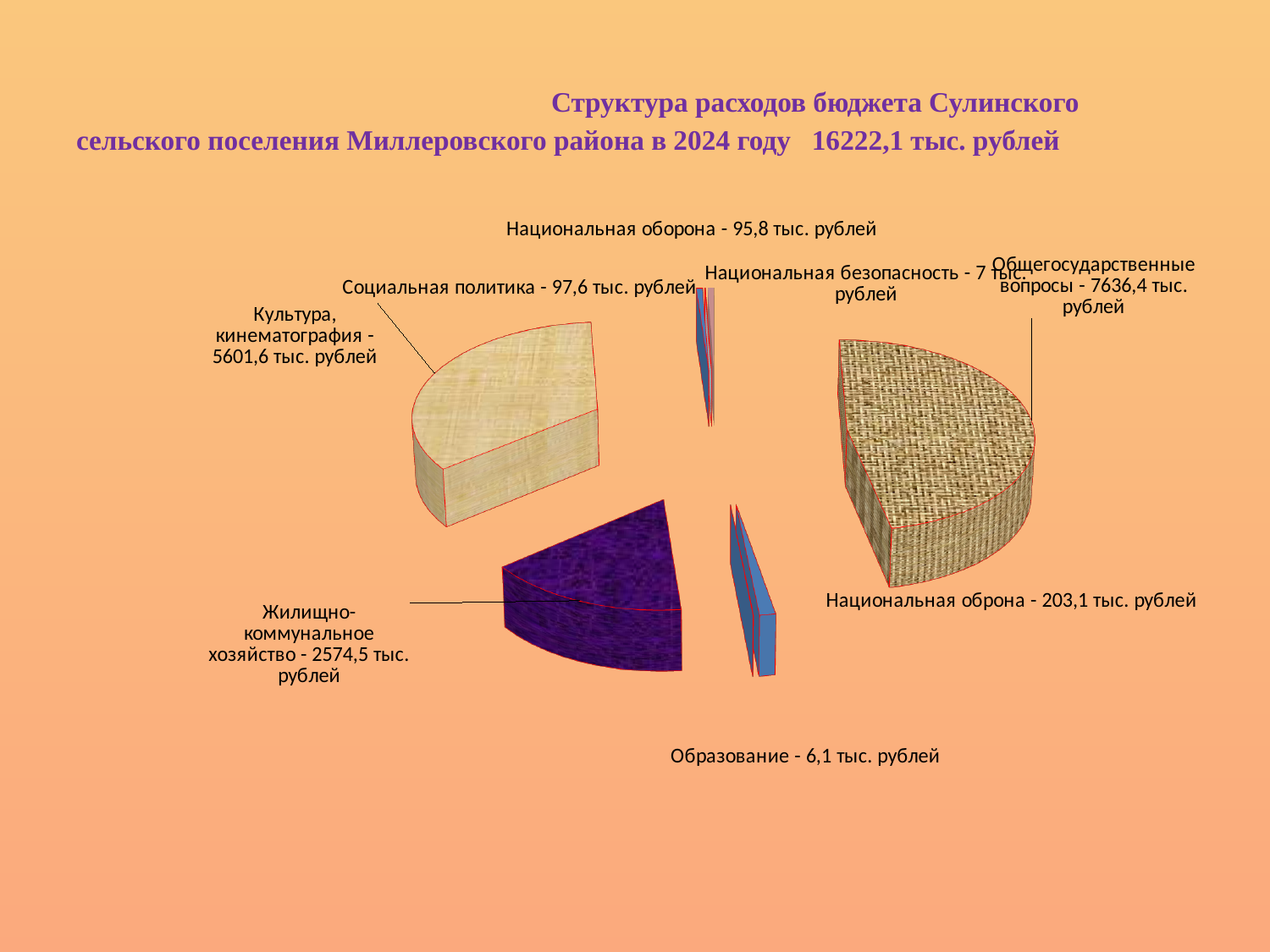
What total budget expenditure is stated in the chart title? 16222,1 тыс. рублей Which is larger: Социальная политика or Национальная оборона (95,8)? Социальная политика What is the value for Жилищно-коммунальное хозяйство? 2574,5 тыс. рублей Which category has the smallest value? Образование What is the value for Культура, кинематография? 5601,6 тыс. рублей What kind of chart is shown on the slide? pie chart What is the value for Образование? 6,1 тыс. рублей Which category has the largest value? Общегосударственные вопросы What is the value for Социальная политика? 97,6 тыс. рублей What is the value for Общегосударственные вопросы? 7636,4 тыс. рублей What is the difference between Общегосударственные вопросы and Культура, кинематография? 2034,8 тыс. рублей How many categories (slices) are labelled on the pie chart? 8